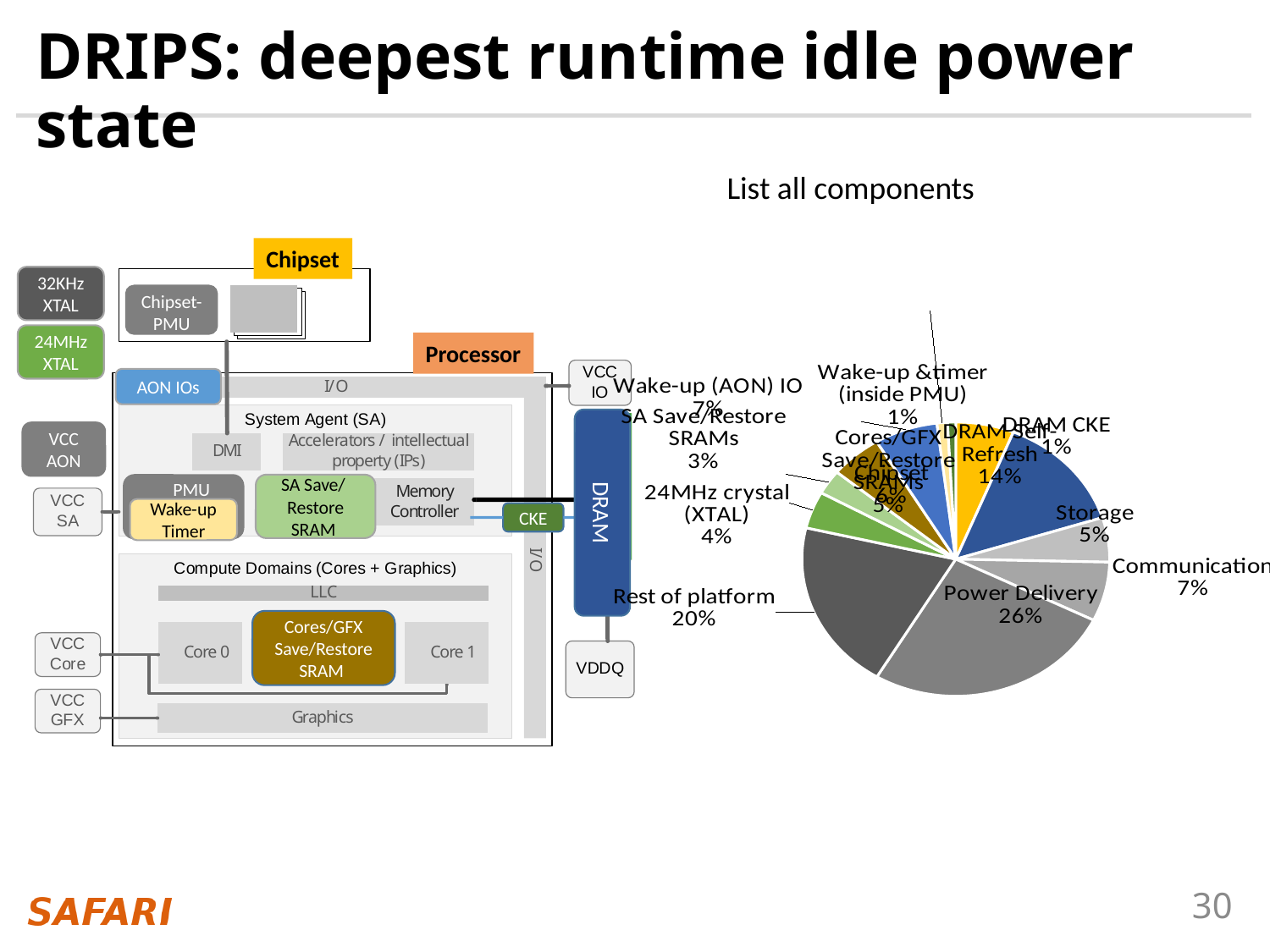
In the pie chart, what is the share for Power Delivery? 26% In the pie chart, what is the share for SA Save/Restore SRAMs? 3% In the pie chart, which component has the largest share? Power Delivery In the pie chart, how many percentage points larger is Power Delivery than Rest of platform? 6 In the pie chart, which has the larger share, Storage or Communication? Communication In the pie chart, what is the share for DRAM CKE? 1% In the pie chart, what is the share for Communication? 7% What kind of chart is shown on the right side of the slide? pie chart In the pie chart, what is the share for Rest of platform? 20% In the pie chart, what is the share for Storage? 5% In the pie chart, what is the share for DRAM Self Refresh? 14% In the pie chart, what is the share for 24MHz crystal (XTAL)? 4%